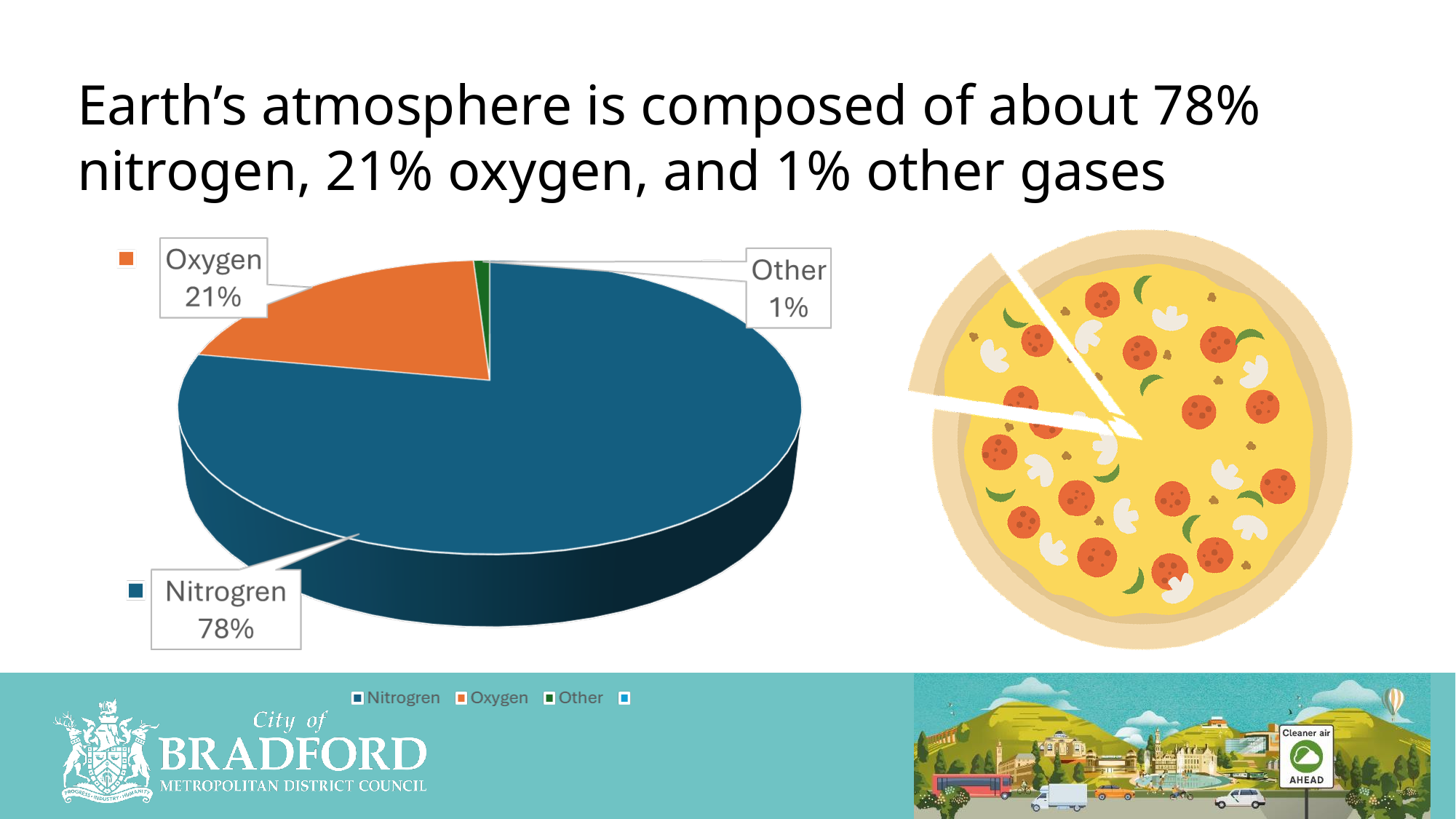
Which slice of the pie chart is the smallest? Other What type of chart is shown on the slide? pie chart What is the difference in percentage points between the Nitrogen and Oxygen slices? 57 What percentage does the pie chart show for Nitrogen? 78% What percentage does the pie chart show for Oxygen? 21% What colour is the Oxygen slice in the pie chart? orange Which is larger in the pie chart, Oxygen or Other? Oxygen What percentage does the pie chart show for Other? 1% What colour is the Nitrogen slice in the pie chart? blue Which slice of the pie chart is the largest? Nitrogren What is the difference in percentage points between the Oxygen and Other slices? 20 How many slices does the pie chart have? 3